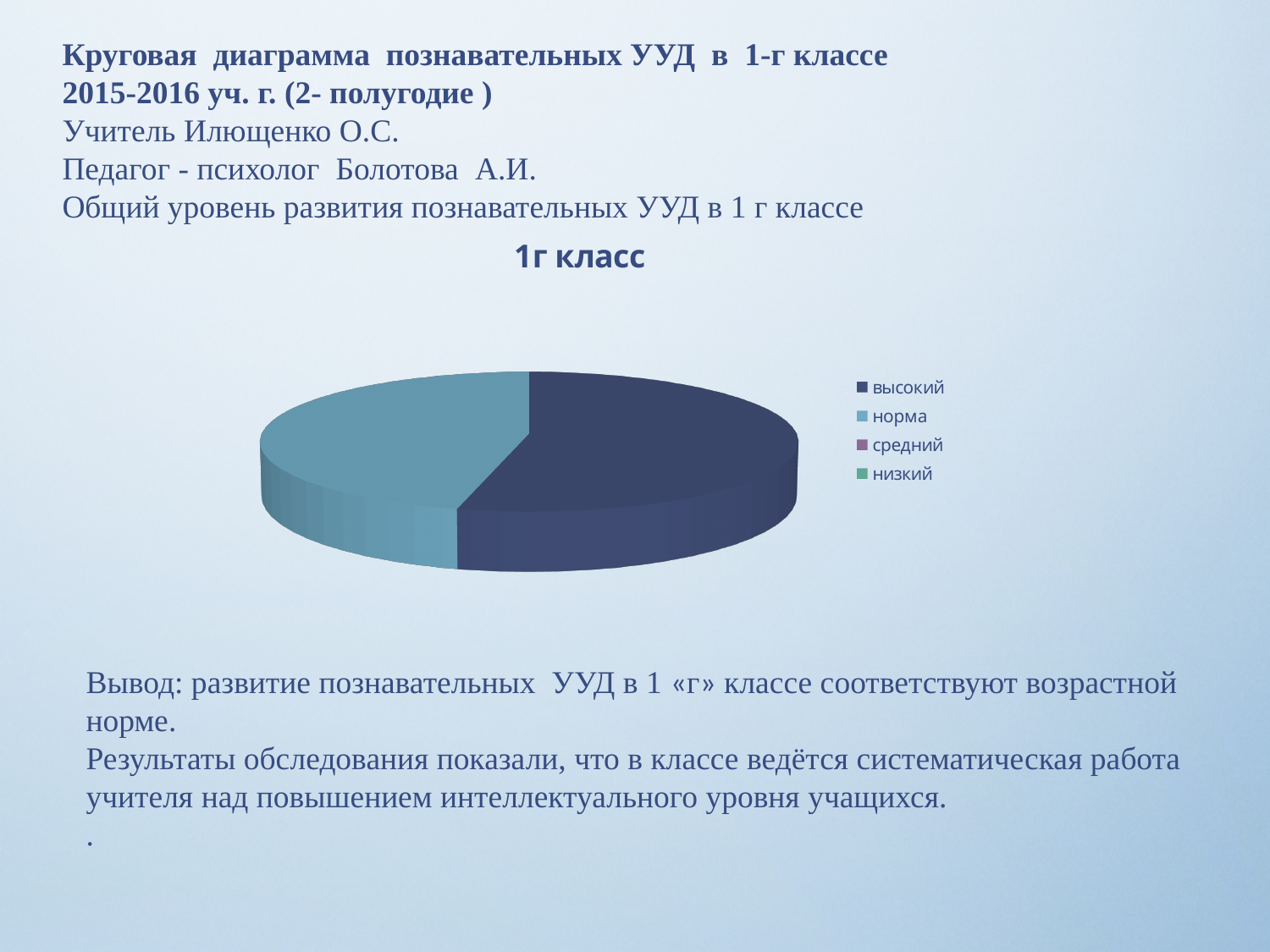
How many slices are visible in the pie chart? 2 Which category has the largest slice in the pie chart? высокий What is the title of the chart? 1г класс Which slice is larger, высокий or норма? высокий Which legend entry is shown in dark blue? высокий What kind of chart is shown on the slide? pie chart Which legend entries do not have a visible slice in the pie chart? средний, низкий How many entries does the chart legend list? 4